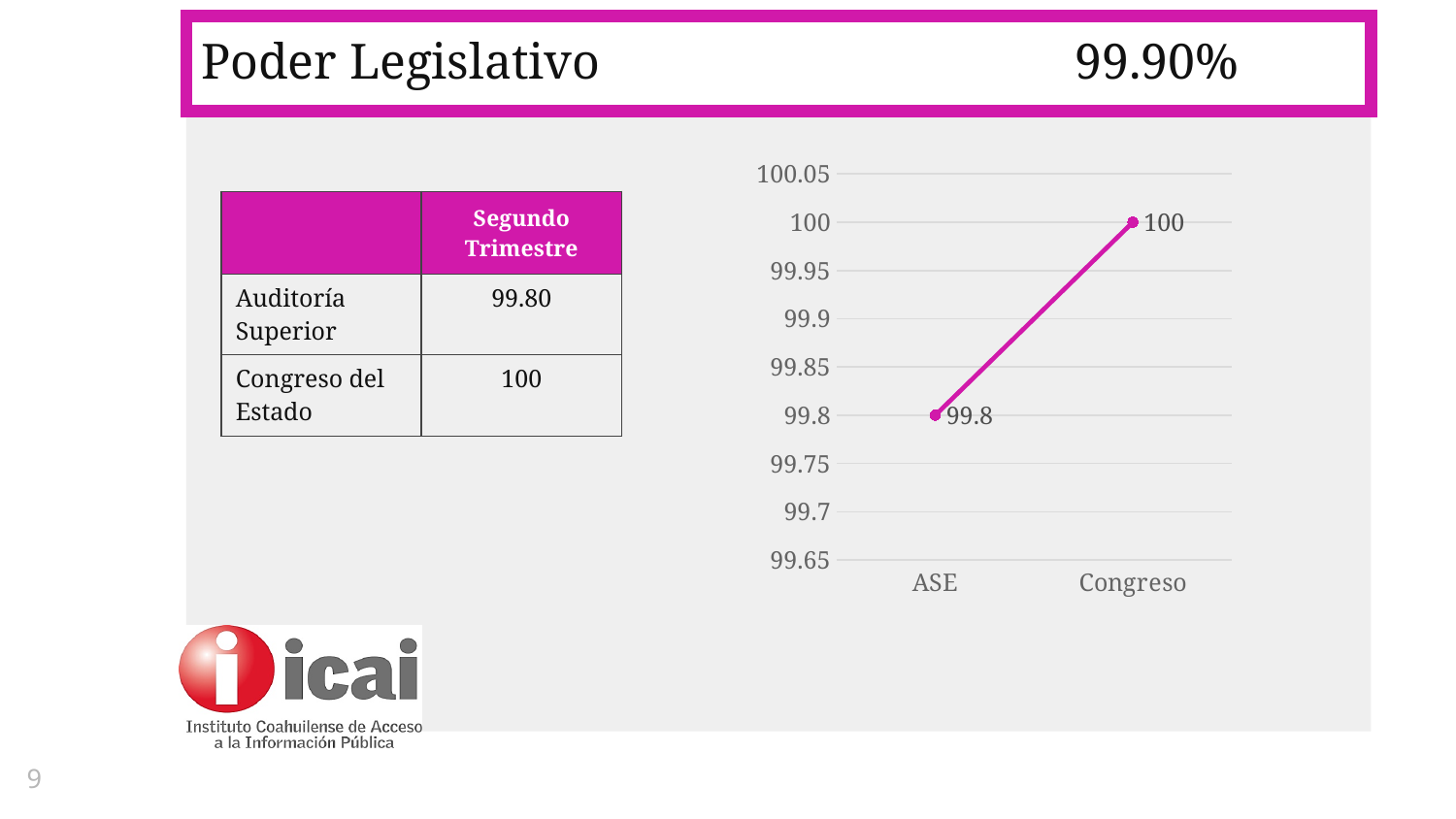
What is the difference between the values for Congreso and ASE? 0.2 What is the value for Congreso in the chart? 100 Is the value for ASE greater or less than 99.9? less Do the values rise or fall from ASE to Congreso? rise Which is larger, the value for ASE or the value for Congreso? Congreso Which category has the highest value in the chart? Congreso What is the value for ASE in the chart? 99.8 What is the lowest value shown on the chart's y axis? 99.65 How many categories are plotted on the x axis of the chart? 2 Which category has the lowest value in the chart? ASE What colour is the line in the chart? magenta What kind of chart is shown on the slide? line chart